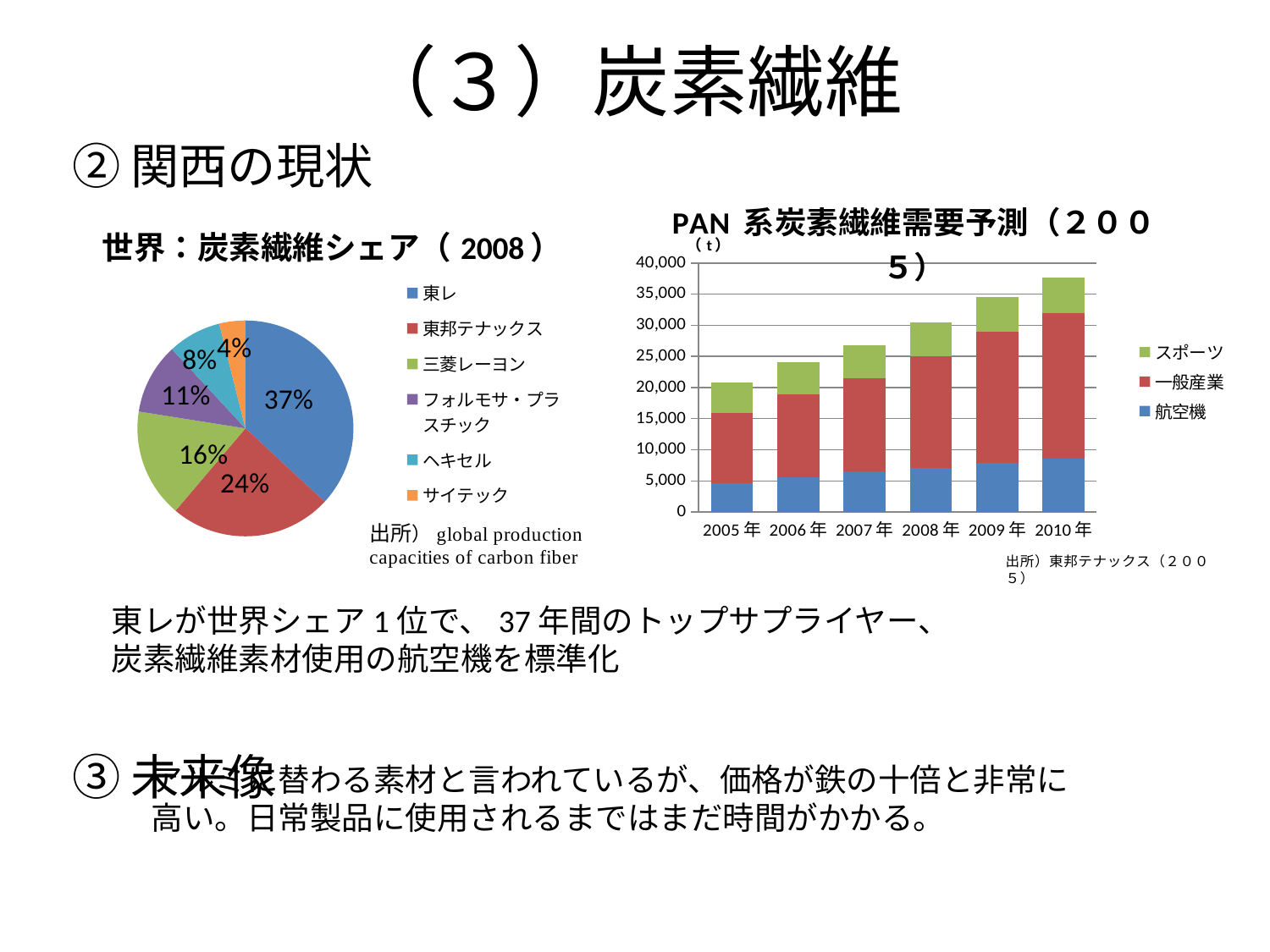
In the pie chart 世界：炭素繊維シェア（2008）, how many companies are shown? 6 In the pie chart 世界：炭素繊維シェア（2008）, what is the difference between the shares of 東レ and 東邦テナックス? 13 percentage points In the PAN系炭素繊維需要予測 chart, do the total values rise or fall from 2005年 to 2010年? rise In the pie chart 世界：炭素繊維シェア（2008）, what share does 三菱レーヨン hold? 16% In the pie chart 世界：炭素繊維シェア（2008）, which company has the largest share? 東レ In the PAN系炭素繊維需要予測 chart, is the total for 2010年 greater or less than 35,000? greater In the PAN系炭素繊維需要予測 chart, how many series does the legend list? 3 In the pie chart 世界：炭素繊維シェア（2008）, which has a larger share, フォルモサ・プラスチック or ヘキセル? フォルモサ・プラスチック In the pie chart 世界：炭素繊維シェア（2008）, what share does 東レ hold? 37% In the pie chart 世界：炭素繊維シェア（2008）, what share does 東邦テナックス hold? 24% In the pie chart 世界：炭素繊維シェア（2008）, which company has the smallest share? サイテック What kind of chart is the PAN系炭素繊維需要予測 chart on the right? Stacked bar chart